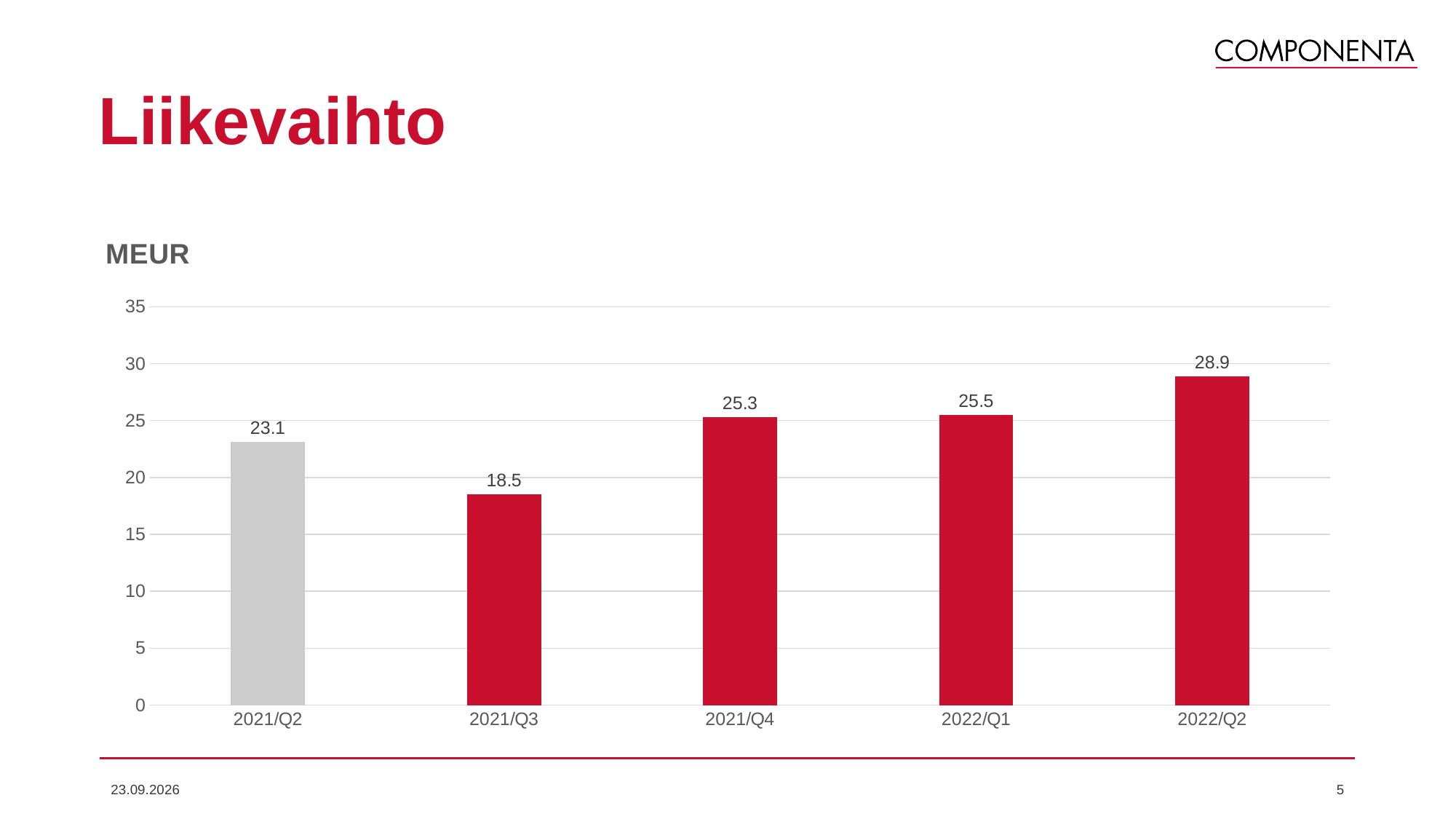
Is the value for 2021/Q3 greater or less than 20? less What is the difference between the values for 2022/Q2 and 2021/Q2? 5.8 What is the value for 2021/Q2? 23.1 What is the difference between the values for 2021/Q4 and 2021/Q3? 6.8 How many quarters are shown on the chart? 5 What kind of chart is shown on the slide? bar chart What is the value for 2022/Q2? 28.9 Which is larger, the value for 2021/Q2 or the value for 2021/Q4? 2021/Q4 Which quarter has the lowest value? 2021/Q3 What is the value for 2021/Q3? 18.5 What unit is shown above the chart? MEUR Which quarter has the highest value? 2022/Q2